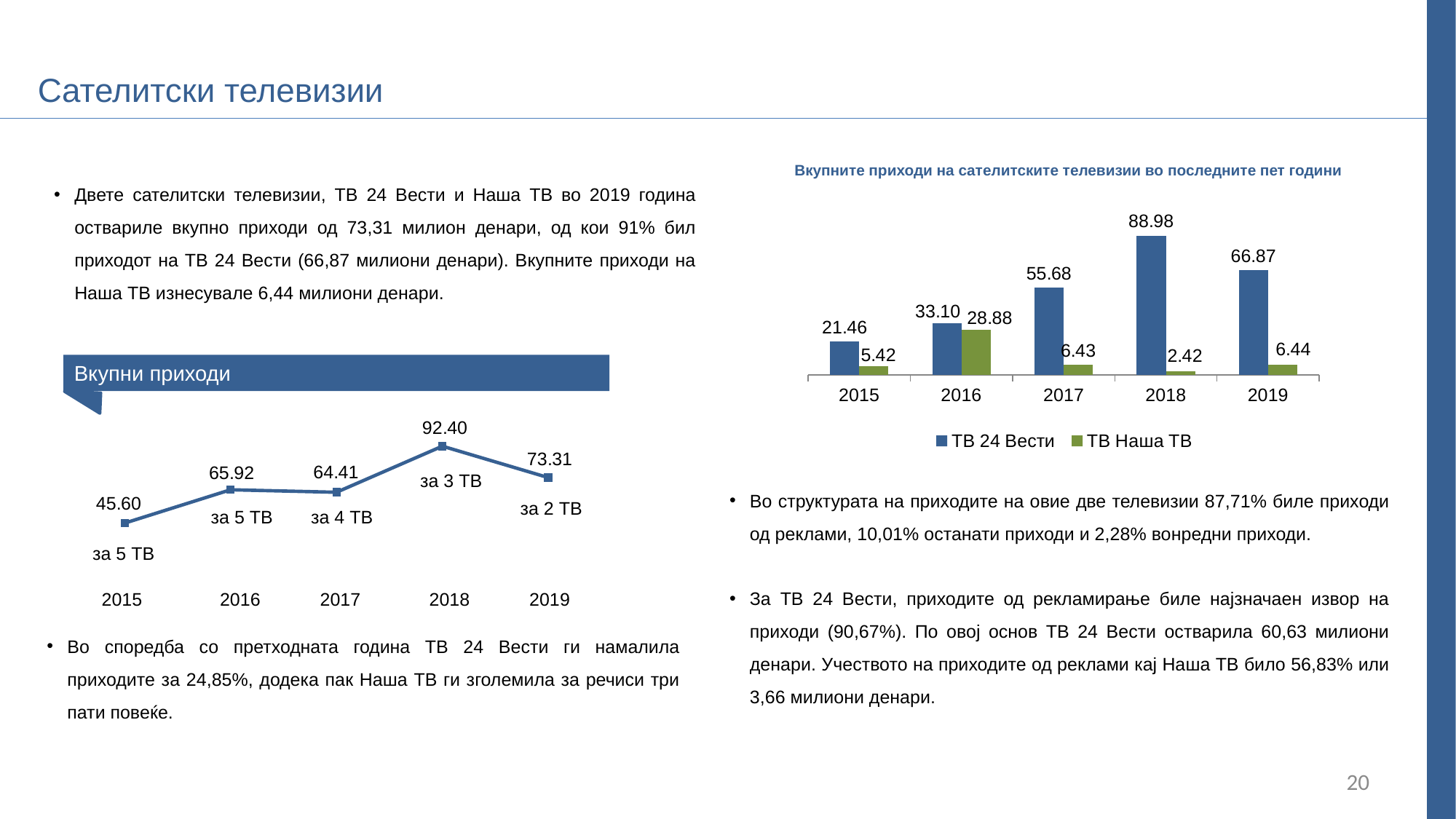
In the line chart titled "Вкупни приходи", which year has the lowest value? 2015 In the bar chart on the right, what is the value for ТВ Наша ТВ in 2016? 28.88 In the bar chart on the right, in which year is the value for ТВ 24 Вести highest? 2018 In the bar chart on the right, how many series does the legend list? 2 What kind of chart is the chart titled "Вкупни приходи"? Line chart In the line chart titled "Вкупни приходи", what is the value for 2018? 92.40 In the bar chart on the right, what is the difference between ТВ 24 Вести and ТВ Наша ТВ in 2019? 60.43 In the line chart titled "Вкупни приходи", how many data points are plotted? 5 In the bar chart on the right, which series is shown in green? ТВ Наша ТВ In the line chart titled "Вкупни приходи", what is the difference between the values for 2018 and 2019? 19.09 In the bar chart on the right, in which year is the value for ТВ Наша ТВ lowest? 2018 In the bar chart on the right, what is the value for ТВ 24 Вести in 2017? 55.68